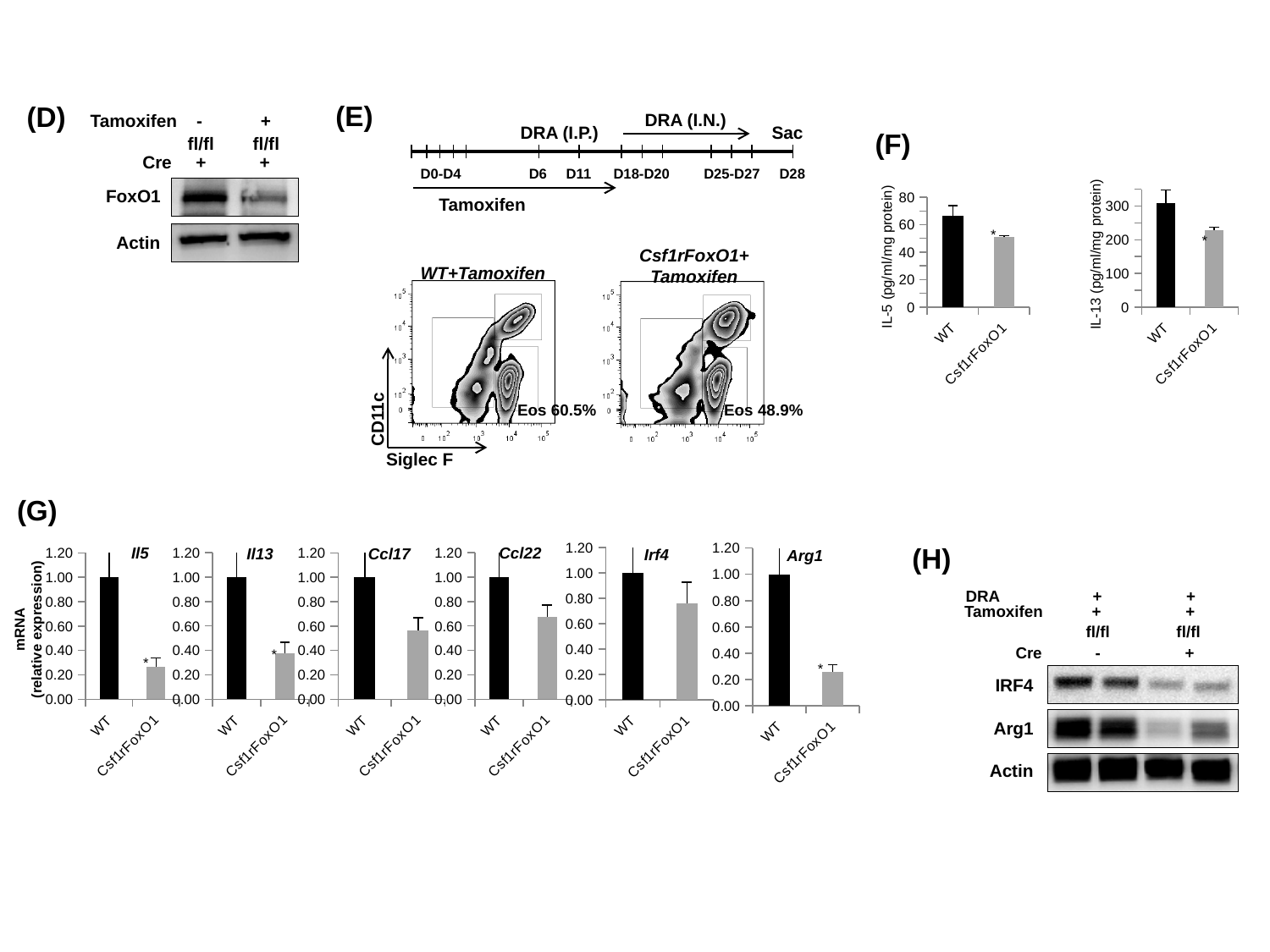
In the Ccl17 chart of panel (G), is the value for Csf1rFoxO1 greater or less than 0.80? less In the flow cytometry plots of panel (E), what is the Eos percentage for Csf1rFoxO1+Tamoxifen? 48.9% In the IL-5 chart of panel (F), is the value for WT greater or less than 60? greater In the IL-5 chart of panel (F), is the value for Csf1rFoxO1 greater or less than 60? less In the Arg1 chart of panel (G), which group has the lowest value? Csf1rFoxO1 What kind of chart is used for IL-5 in panel (F)? bar chart In the flow cytometry plots of panel (E), what is the Eos percentage for WT+Tamoxifen? 60.5% In the IL-13 chart of panel (F), which group has the higher value, WT or Csf1rFoxO1? WT How many bar charts are shown in panel (G)? 6